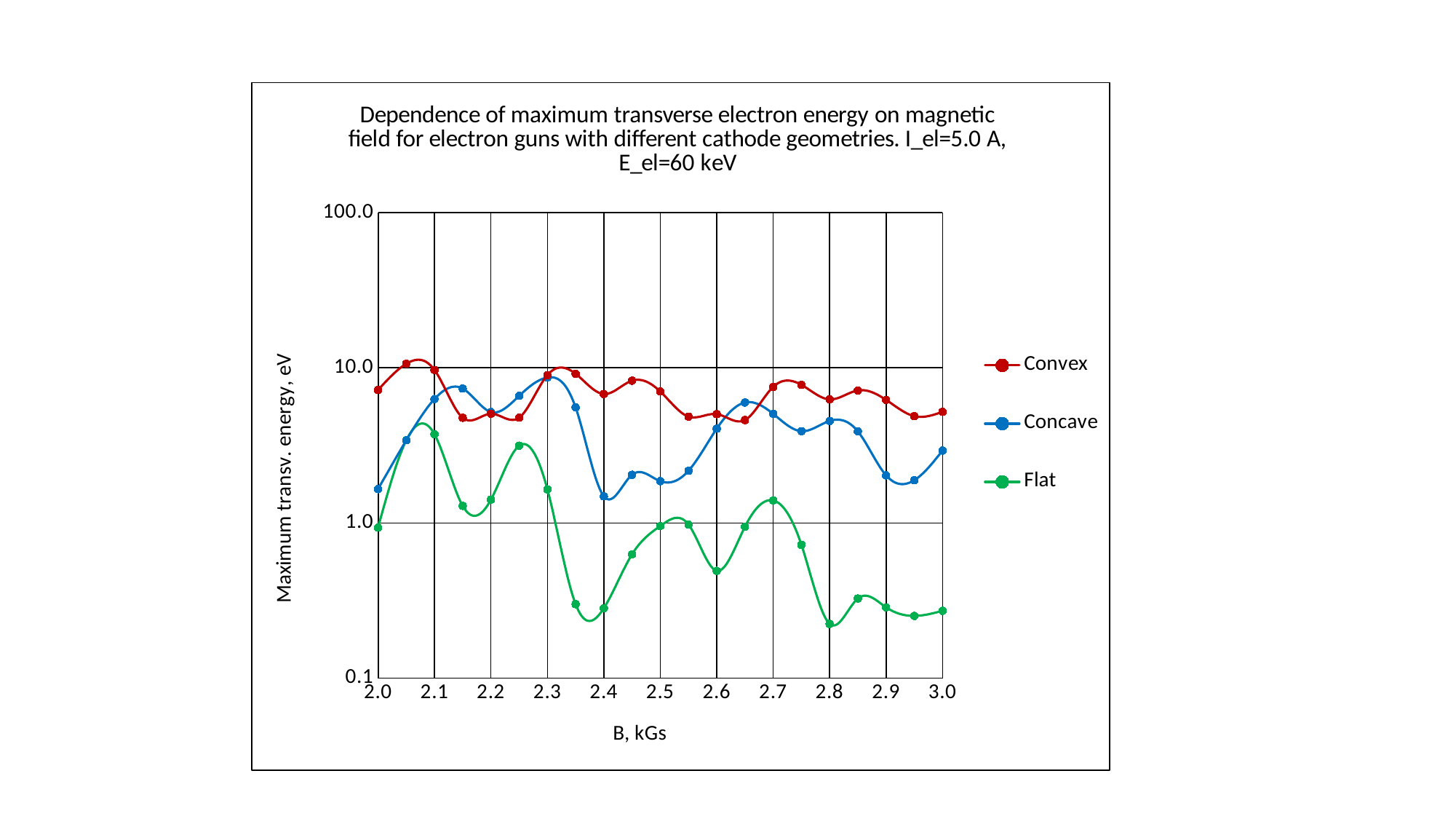
Is the value of the Flat series at B = 2.4 greater or less than 1.0? less Is the value of the Flat series at B = 2.8 greater or less than 1.0? less What are the names of the series in the legend? Convex, Concave, Flat What is the label of the x axis? B, kGs Is the Flat series lower or higher at B = 3.0 than at B = 2.0? lower Is the value of the Convex series at B = 2.0 greater or less than 1.0? greater Which series has the highest values across the chart? Convex At B = 2.4, which series has the larger value, Concave or Flat? Concave Which series has the lowest values across the chart? Flat How many series does the legend list? 3 How many tick labels are shown on the x axis? 11 What kind of chart is shown on the slide? Line chart